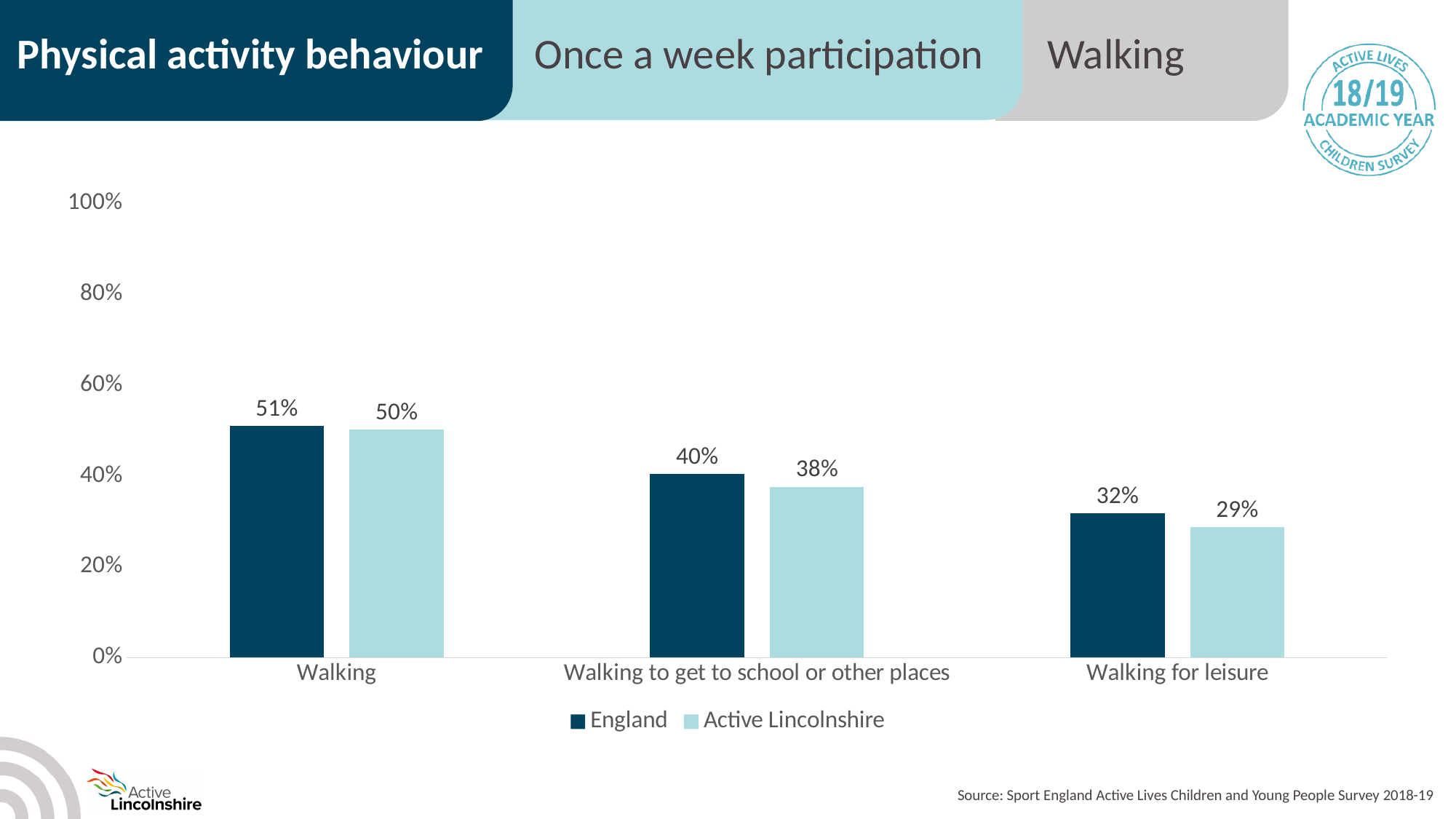
Which category has the lowest Active Lincolnshire value? Walking for leisure Is the England value for Walking to get to school or other places greater or less than 60%? less What is the Active Lincolnshire value for Walking for leisure? 29% Which is larger for Walking to get to school or other places: England or Active Lincolnshire? England What is the difference between the England and Active Lincolnshire values for Walking for leisure? 3% What is the England value for Walking? 51% Which category has the highest England value? Walking What is the difference between the England values for Walking and Walking for leisure? 19% How many series does the legend list? 2 What is the Active Lincolnshire value for Walking to get to school or other places? 38% How many categories are shown on the x axis? 3 What kind of chart is shown on the slide? bar chart